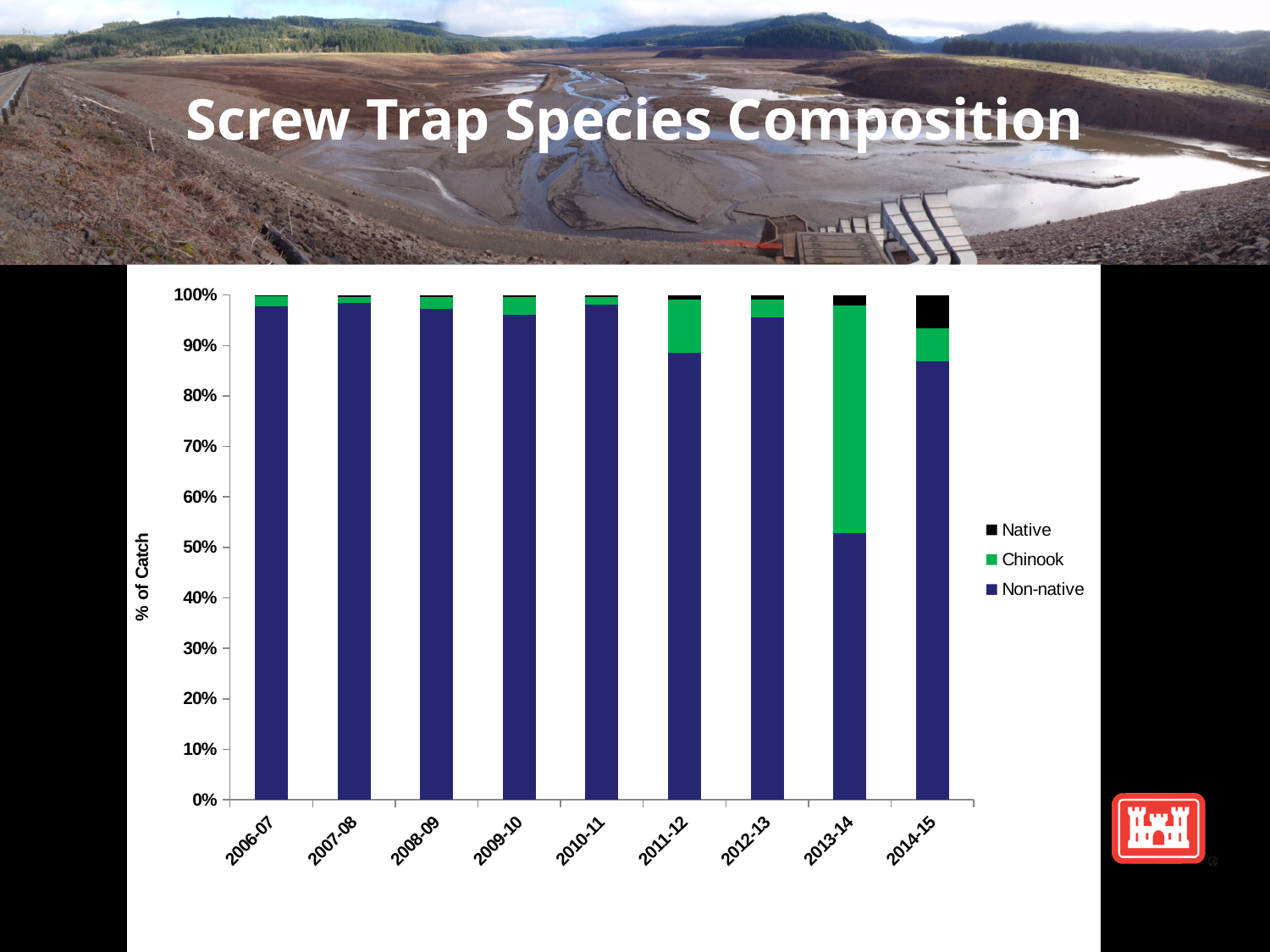
What is the title of the chart? Screw Trap Species Composition What kind of chart is shown on the slide? Stacked bar chart Is the Chinook share of the catch in 2013-14 greater or less than 40%? greater How many series does the legend list? 3 In which season is the Chinook share of the catch highest? 2013-14 What is the label on the y axis? % of Catch Which season has the larger Non-native share of the catch, 2011-12 or 2012-13? 2012-13 How many trapping seasons (categories) are shown on the x axis? 9 In which season is the Non-native share of the catch lowest? 2013-14 Is the Non-native share of the catch in 2014-15 greater or less than 80%? greater Is the Non-native share of the catch in 2013-14 greater or less than 60%? less In which season is the Native share of the catch highest? 2014-15